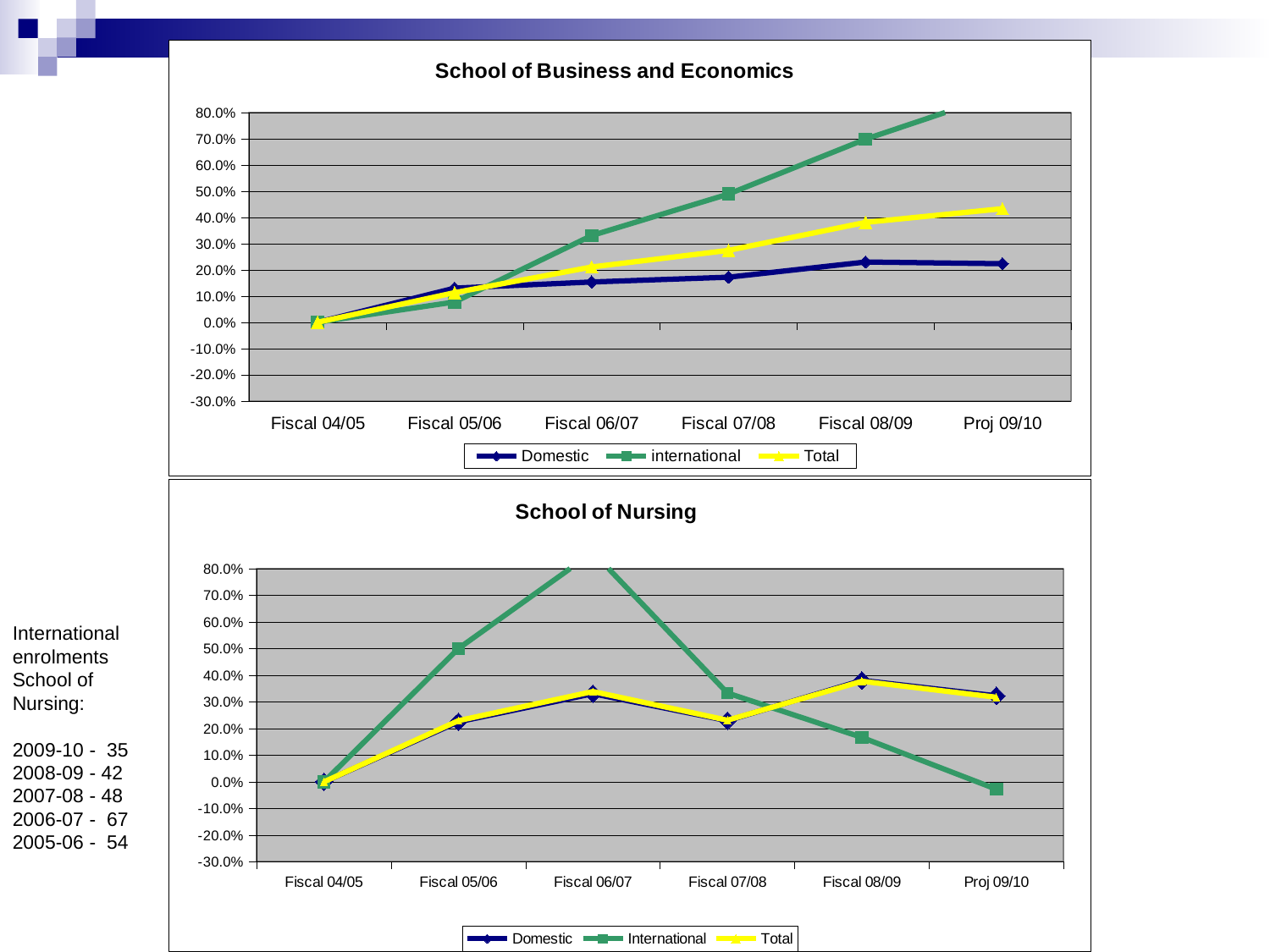
What kind of chart is the School of Business and Economics chart? line chart How many fiscal periods are shown on the x axis of the School of Nursing chart? 6 In the School of Business and Economics chart, does the international series rise or fall from Fiscal 04/05 to Proj 09/10? rise In the School of Business and Economics chart, is the Domestic value for Proj 09/10 greater or less than 30.0%? less In the School of Nursing chart, at which fiscal period is the International series lowest? Proj 09/10 In the School of Business and Economics chart, is the international value for Fiscal 08/09 greater or less than 60.0%? greater How many series does the legend of the School of Business and Economics chart list? 3 In the School of Business and Economics chart, which series has the highest value at Fiscal 08/09? international In the School of Nursing chart, is the International value for Fiscal 05/06 greater or less than 40.0%? greater What are the three legend entries of the School of Nursing chart? Domestic, International, Total In the School of Nursing chart, at which fiscal period does the International series reach its highest value? Fiscal 06/07 In the School of Business and Economics chart, which is larger at Proj 09/10, Total or Domestic? Total